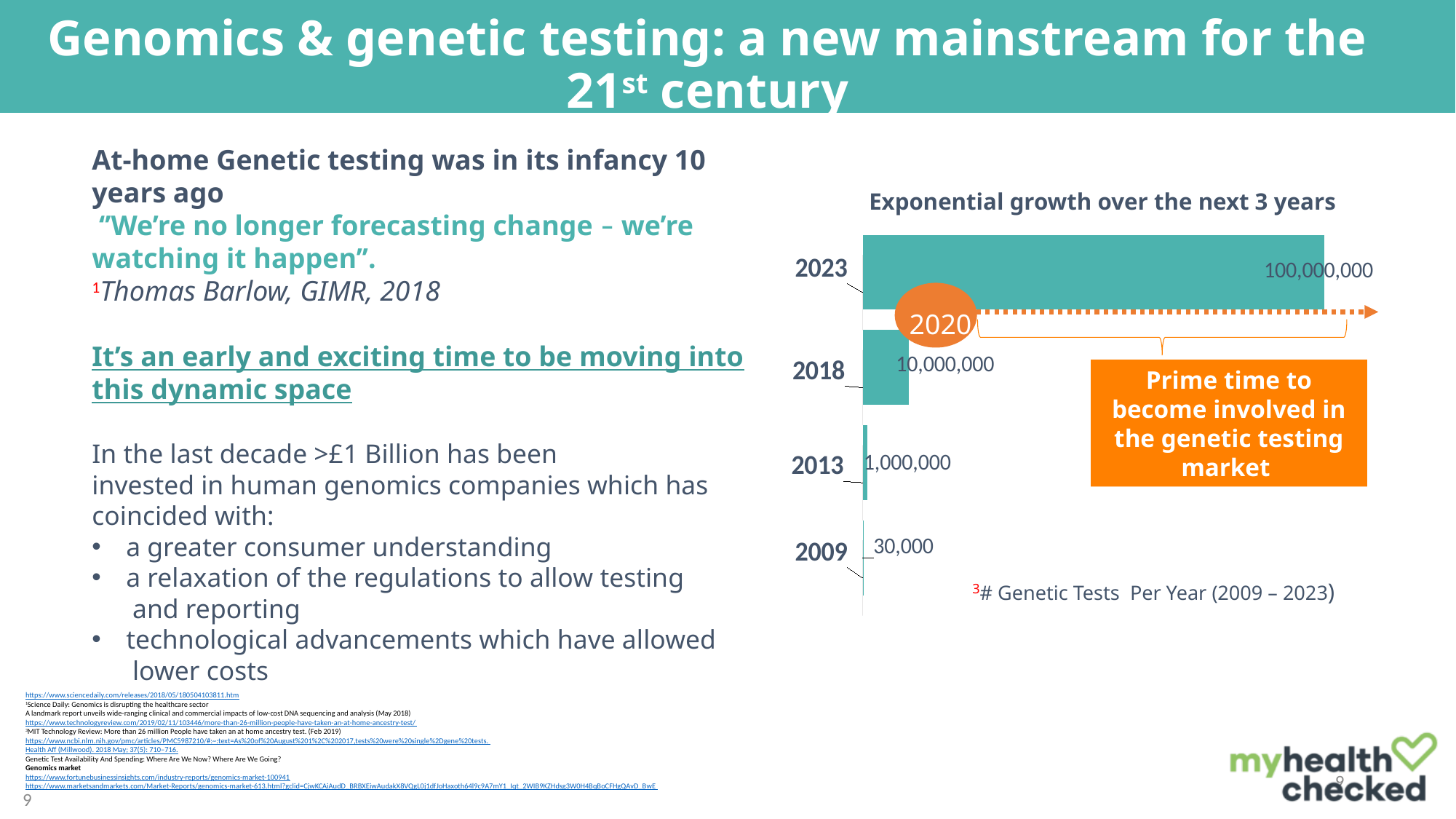
What kind of chart is shown on the slide? bar chart Do the values rise or fall as the years go from 2009 to 2023? rise What is the value for 2018 in the chart? 10,000,000 What is the difference between the values for 2023 and 2018? 90,000,000 Which is larger, the value for 2013 or the value for 2009? 2013 Which year has the lowest value in the chart? 2009 Which year has the highest value in the chart? 2023 What is the value for 2009 in the chart? 30,000 What is the value for 2023 in the chart? 100,000,000 What is the value for 2013 in the chart? 1,000,000 How many years are plotted in the chart? 4 What is the title of the chart? Exponential growth over the next 3 years